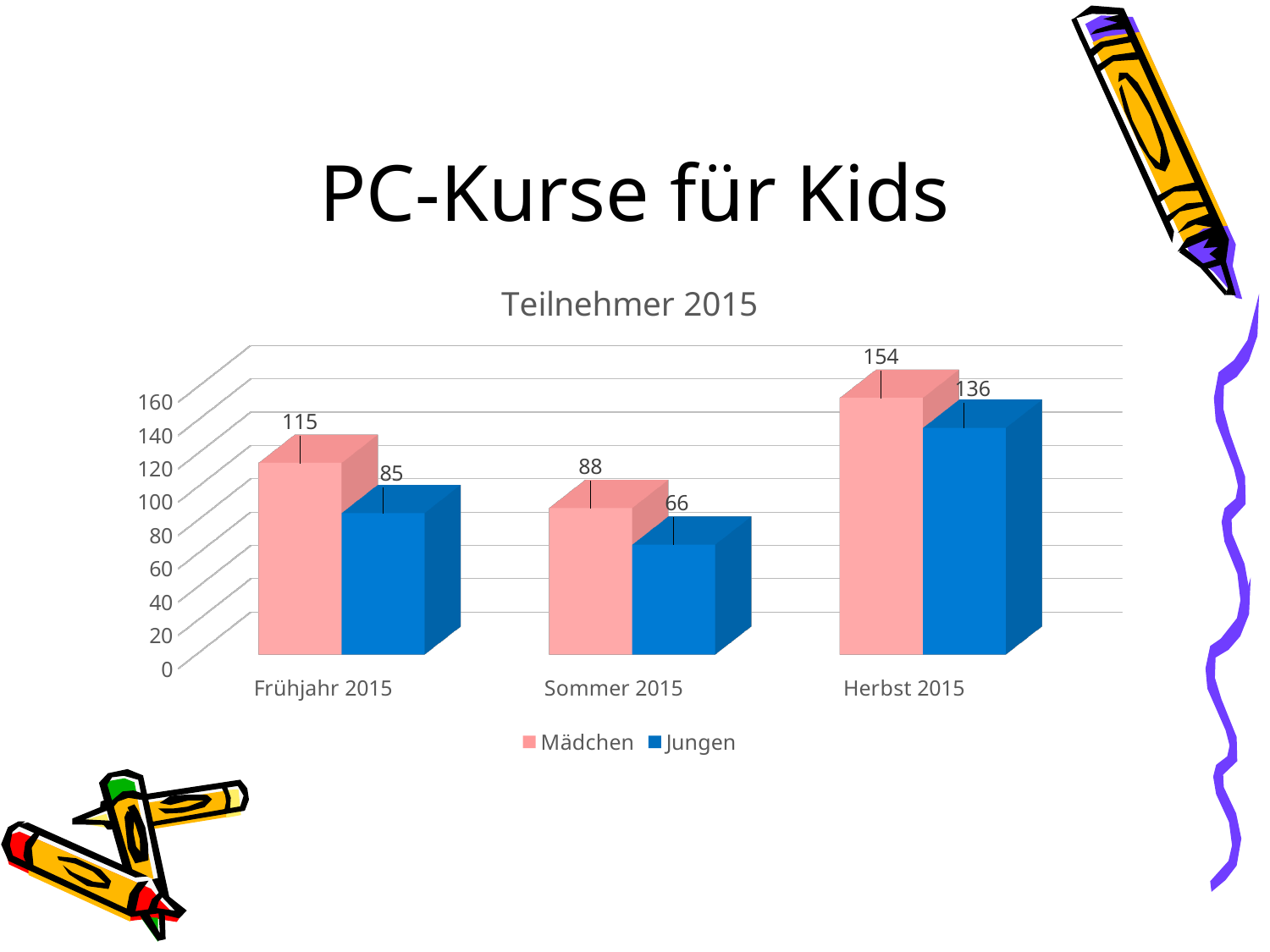
In which period is the Jungen value lowest? Sommer 2015 What is the difference between Mädchen and Jungen in Frühjahr 2015? 30 What is the difference between the Mädchen values for Herbst 2015 and Sommer 2015? 66 How many series does the legend list? 2 What is the value for Jungen in Sommer 2015? 66 What kind of chart is shown? Bar chart Which is larger in Herbst 2015, Mädchen or Jungen? Mädchen What is the title of the chart? Teilnehmer 2015 How many periods are shown on the x axis? 3 In which period is the Mädchen value highest? Herbst 2015 What is the value for Jungen in Herbst 2015? 136 What is the value for Mädchen in Frühjahr 2015? 115